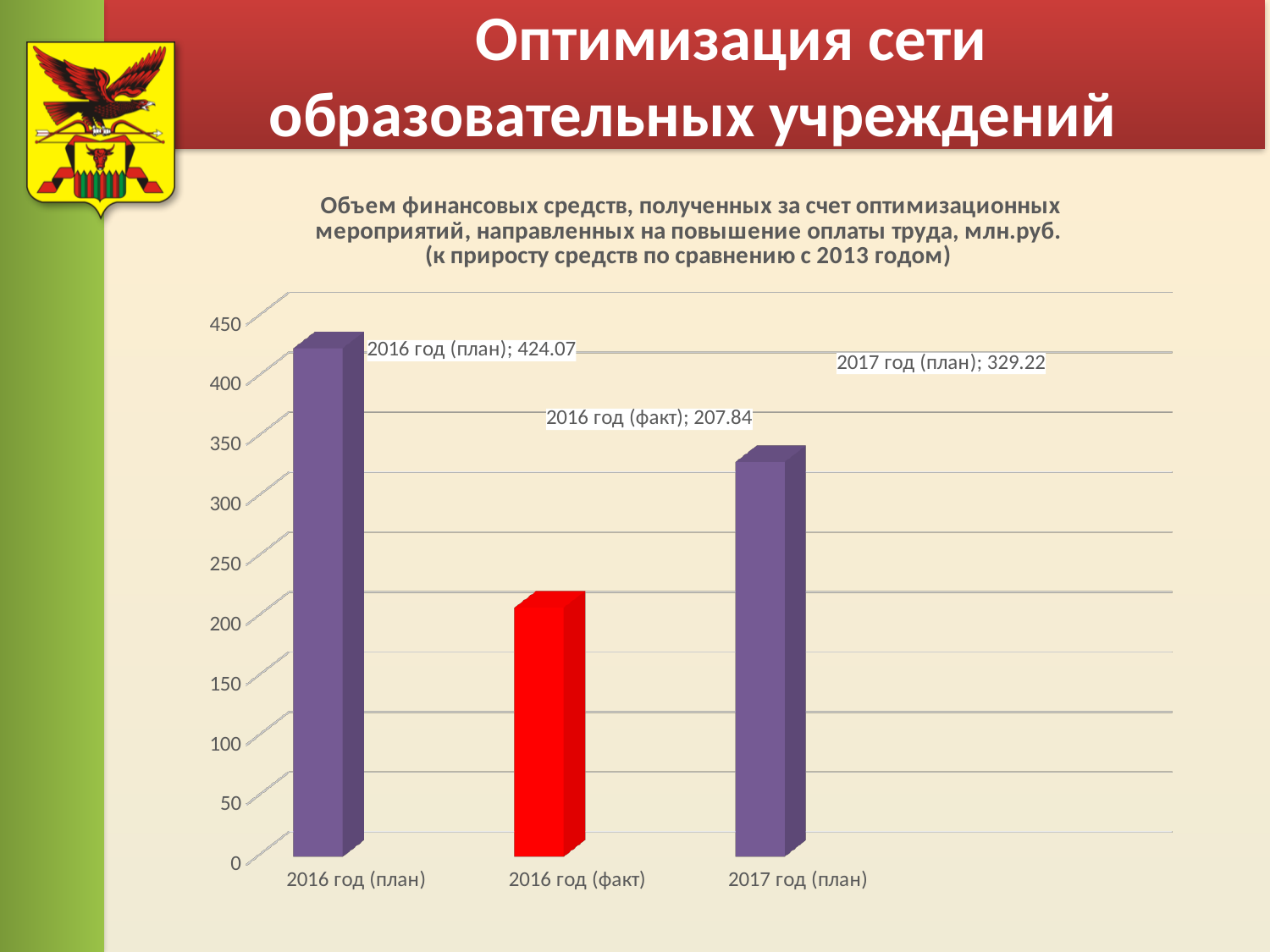
What is the difference between the values for 2017 год (план) and 2016 год (факт)? 121.38 Is the value for 2017 год (план) greater or less than 300? greater What is the value for 2016 год (факт)? 207.84 Which is larger, the value for 2017 год (план) or the value for 2016 год (факт)? 2017 год (план) Which category has the lowest value? 2016 год (факт) What is the difference between the values for 2016 год (план) and 2016 год (факт)? 216.23 What colour is the bar for 2016 год (факт)? red What is the value for 2017 год (план)? 329.22 Which category has the highest value? 2016 год (план) What kind of chart is shown on the slide? bar chart How many categories are shown on the x axis? 3 What is the value for 2016 год (план)? 424.07